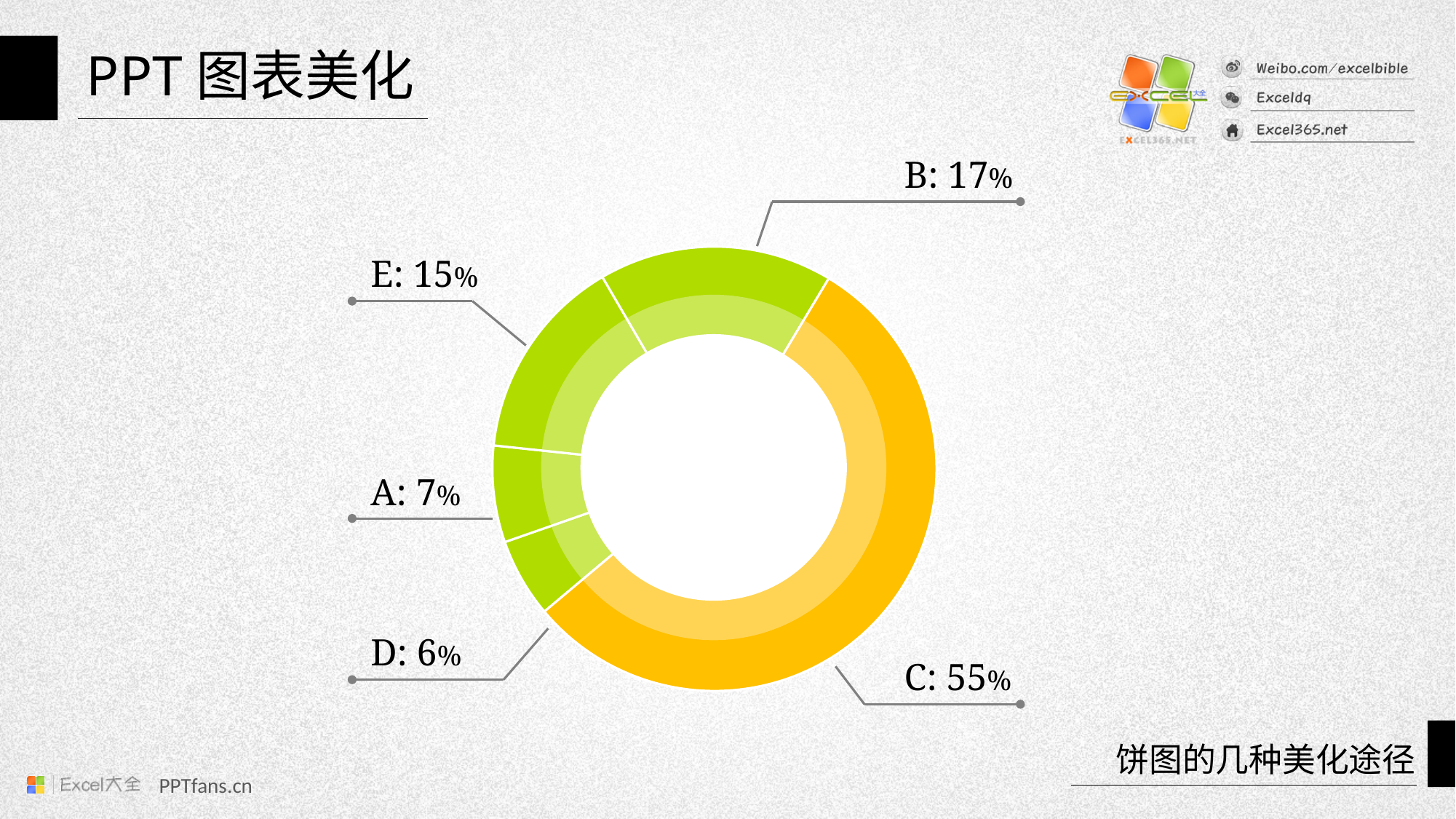
Which category's segment is coloured orange rather than green? C Which category has the largest share of the chart? C What percentage is shown for category A? 7% Which category has the smallest share of the chart? D What percentage is shown for category C? 55% What is the difference in percentage points between category C and category B? 38 What is the combined share of categories A and D? 13% How many categories are shown in the chart? 5 What percentage is shown for category E? 15% What kind of chart is shown on the slide? Doughnut (pie) chart What percentage is shown for category B? 17% Which is larger, the share for E or the share for B? B